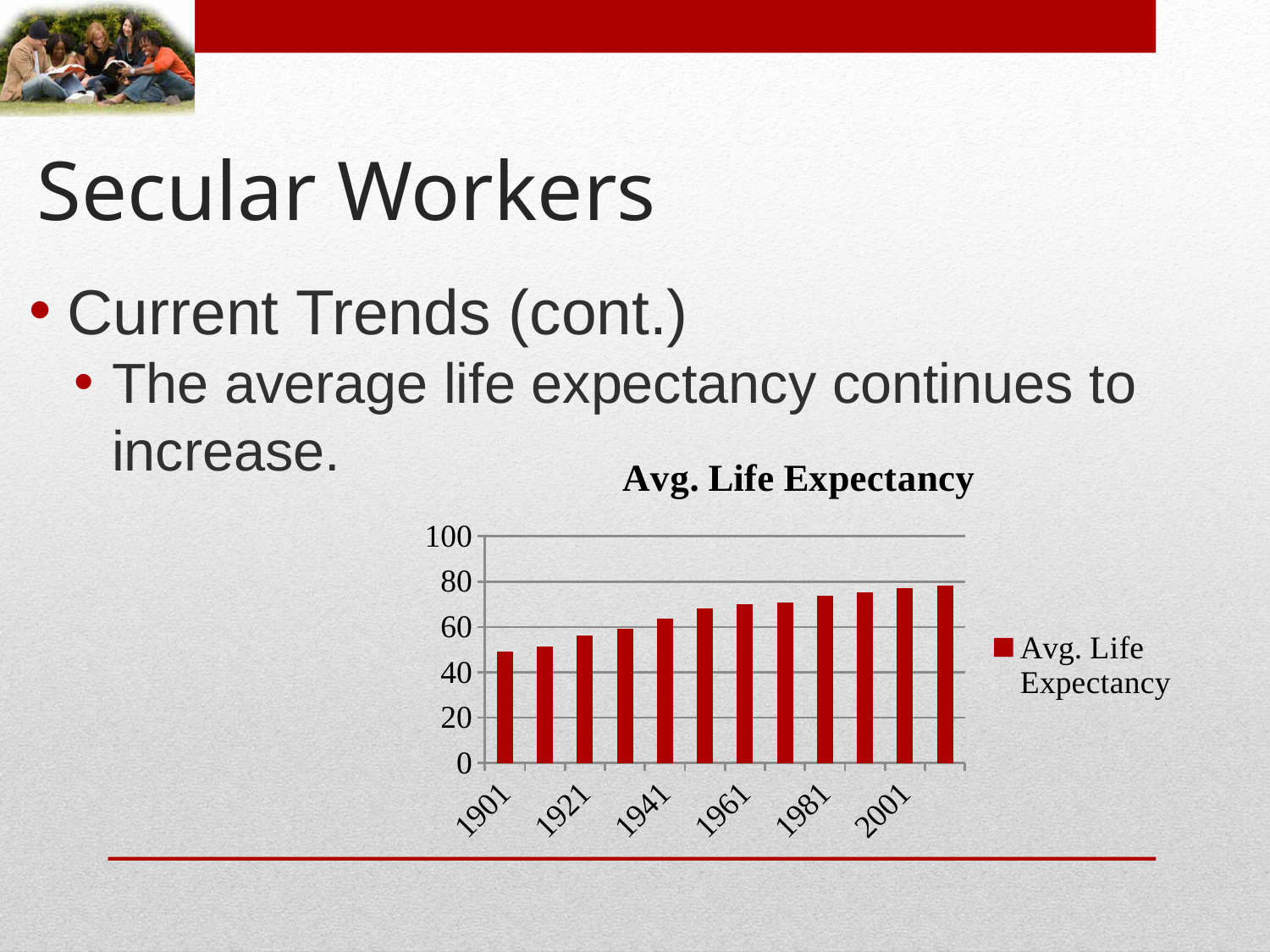
How many bars are plotted in the chart? 12 Is the value for 1981 greater or less than 80? less Which has the larger value, 1921 or 1961? 1961 How many series does the legend list? 1 Is the value for 1901 greater or less than 40? greater Is the value for 1901 greater or less than 60? less What is the title of the chart? Avg. Life Expectancy Do the values rise or fall from 1901 to 2001 along the x axis? rise Among the labeled years on the x axis, which has the lowest value? 1901 Which has the larger value, 1901 or 2001? 2001 What kind of chart is shown on the slide? bar chart